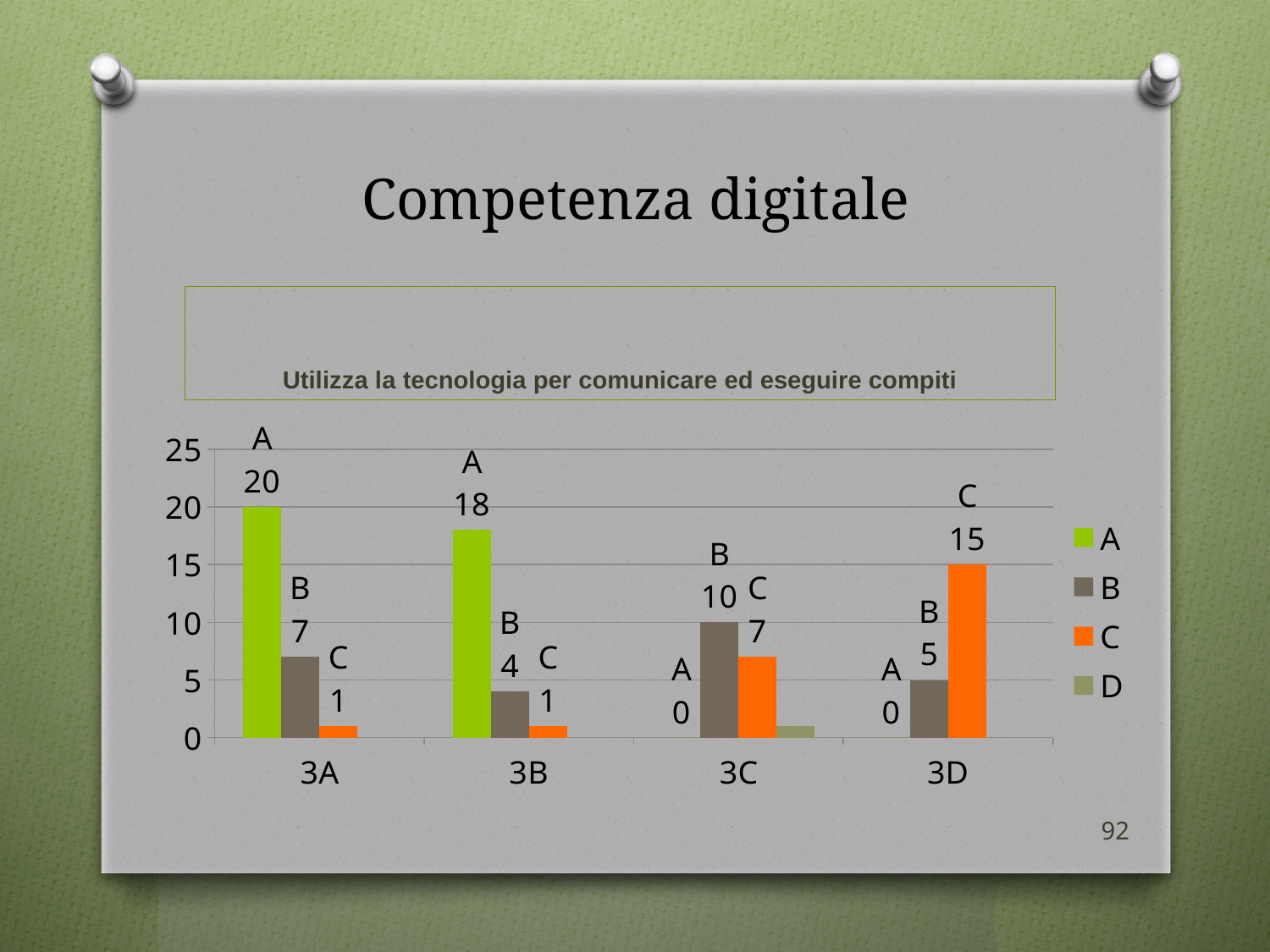
What is the difference between the series A values for 3A and 3B? 2 What is the value of series A for class 3A? 20 Which is larger: series B for 3C or series C for 3C? Series B for 3C Which class has the highest value for series A? 3A What is the value of series A for class 3B? 18 What is the title of the slide containing the chart? Competenza digitale How many series does the legend list? 4 Which class has the lowest value for series B? 3B What kind of chart is shown on the slide? Bar chart What is the value of series C for class 3D? 15 What is the value of series B for class 3C? 10 How many classes are shown on the x axis? 4